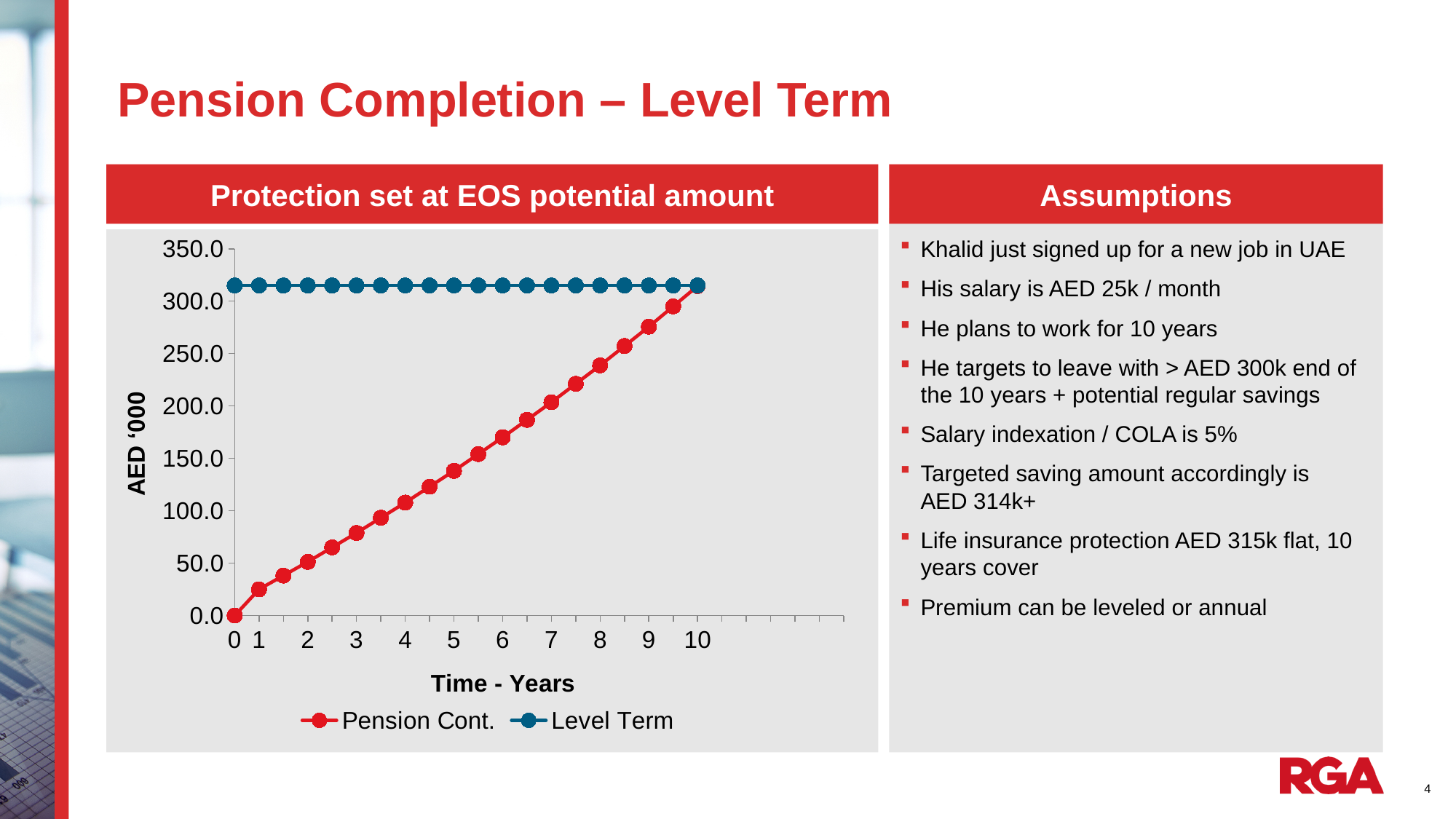
What kind of chart is shown on the slide? Line chart At year 5, which series has the higher value, Pension Cont. or Level Term? Level Term How many series does the chart legend list? 2 What are the two series named in the chart legend? Pension Cont. and Level Term Is the value of Pension Cont. at year 5 greater or less than 150.0? less Is the value of Pension Cont. at year 8 greater or less than 200.0? greater What is the label of the chart's vertical axis? AED '000 Does the Level Term series rise, fall or stay flat across the years shown? Stays flat What is the value of Pension Cont. at year 0? 0.0 Is the value of the Level Term series greater or less than 300.0? greater Does the Pension Cont. series rise or fall as time increases along the x axis? Rises